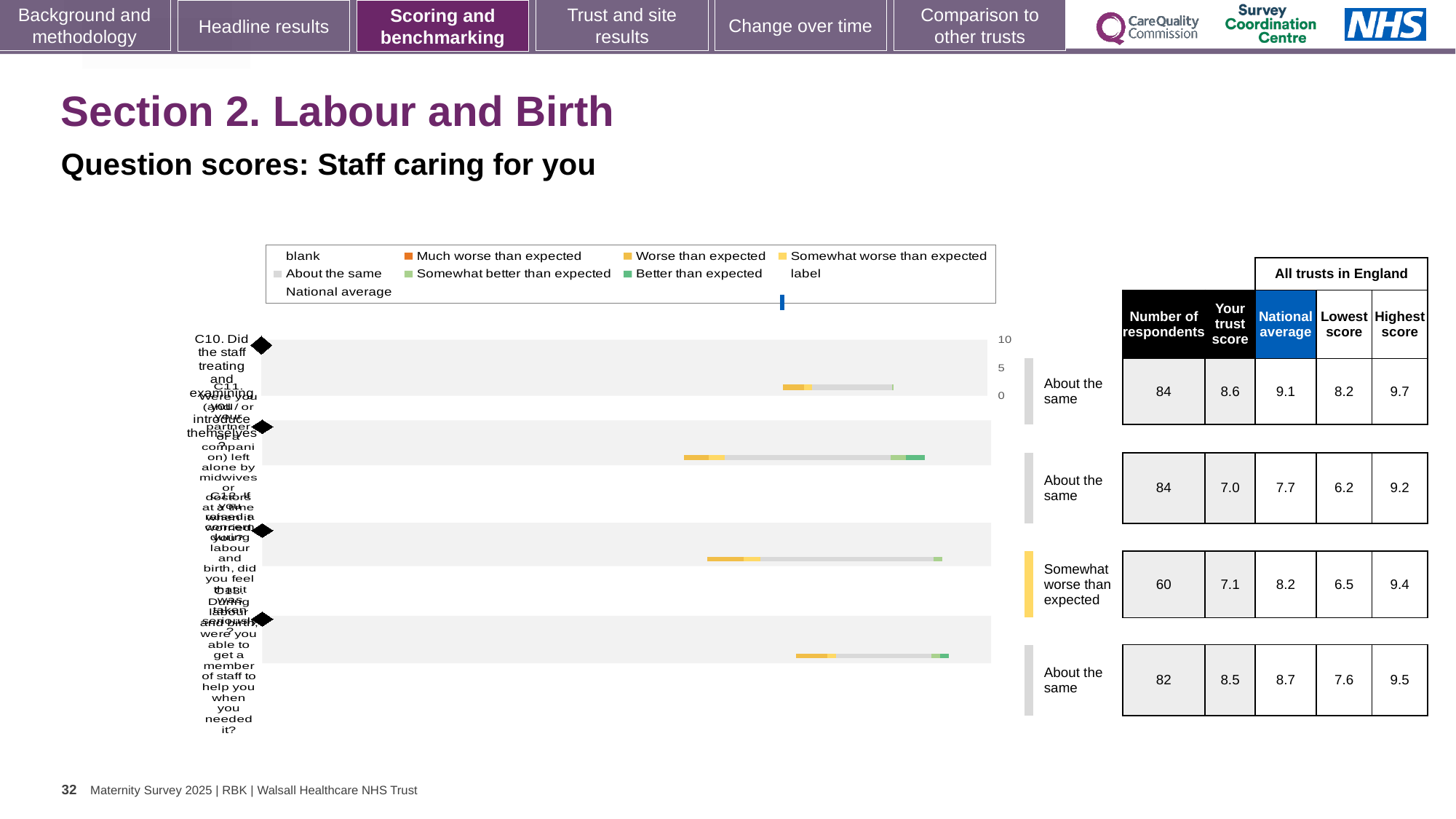
In the table beside the chart, which row has the highest 'Your trust score'? the first row (8.6) In the table beside the chart, which row has the lowest 'Your trust score'? the second row (7.0) In the table beside the chart, is the trust score in the second row larger or smaller than the national average in that row? smaller Which legend entry is shown in dark orange? Much worse than expected What kind of chart is shown on the slide? bar chart How many question rows (bars) does the chart show? 4 In the table beside the chart, what is the trust score for the third row (Somewhat worse than expected)? 7.1 In the table beside the chart, what is the number of respondents for the first row? 84 In the table beside the chart, what is the difference between the national average and the trust score in the first row? 0.5 In the table beside the chart, what is the national average for the last row? 8.7 Which legend entry is shown in grey? About the same